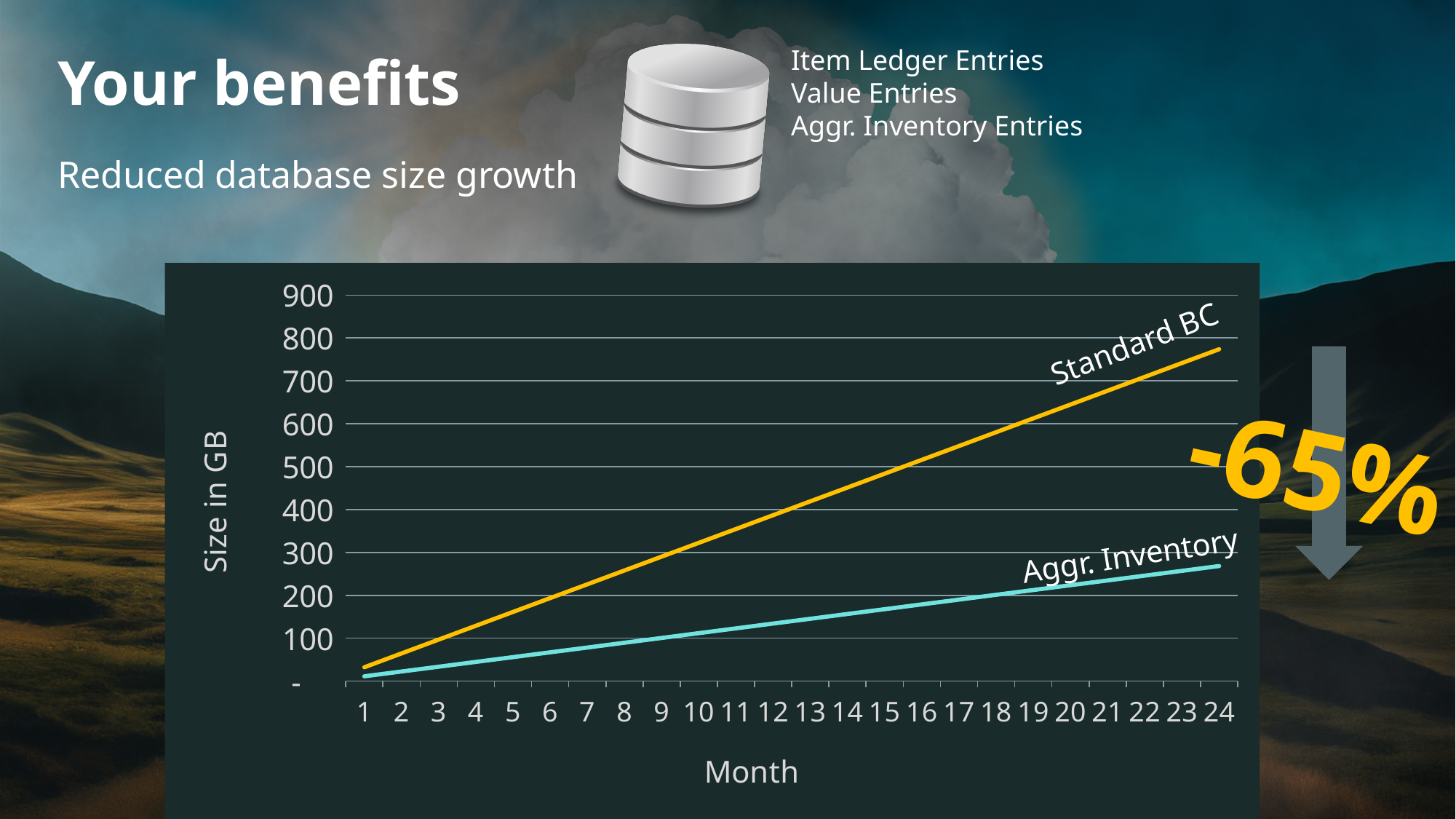
Is the value for Aggr. Inventory at month 24 greater or less than 300? less Is the value for Standard BC at month 18 greater or less than 500? greater Is the value for Standard BC at month 24 greater or less than 700? greater Do the values for Standard BC rise or fall as the months increase? rise What percentage reduction is highlighted next to the chart? -65% What kind of chart is shown on the slide? line chart Which series has the larger value at month 24, Standard BC or Aggr. Inventory? Standard BC How many series are plotted on the chart? 2 How many months are shown along the x axis of the chart? 24 Do the values for Aggr. Inventory rise or fall as the months increase? rise What is the label of the y axis of the chart? Size in GB